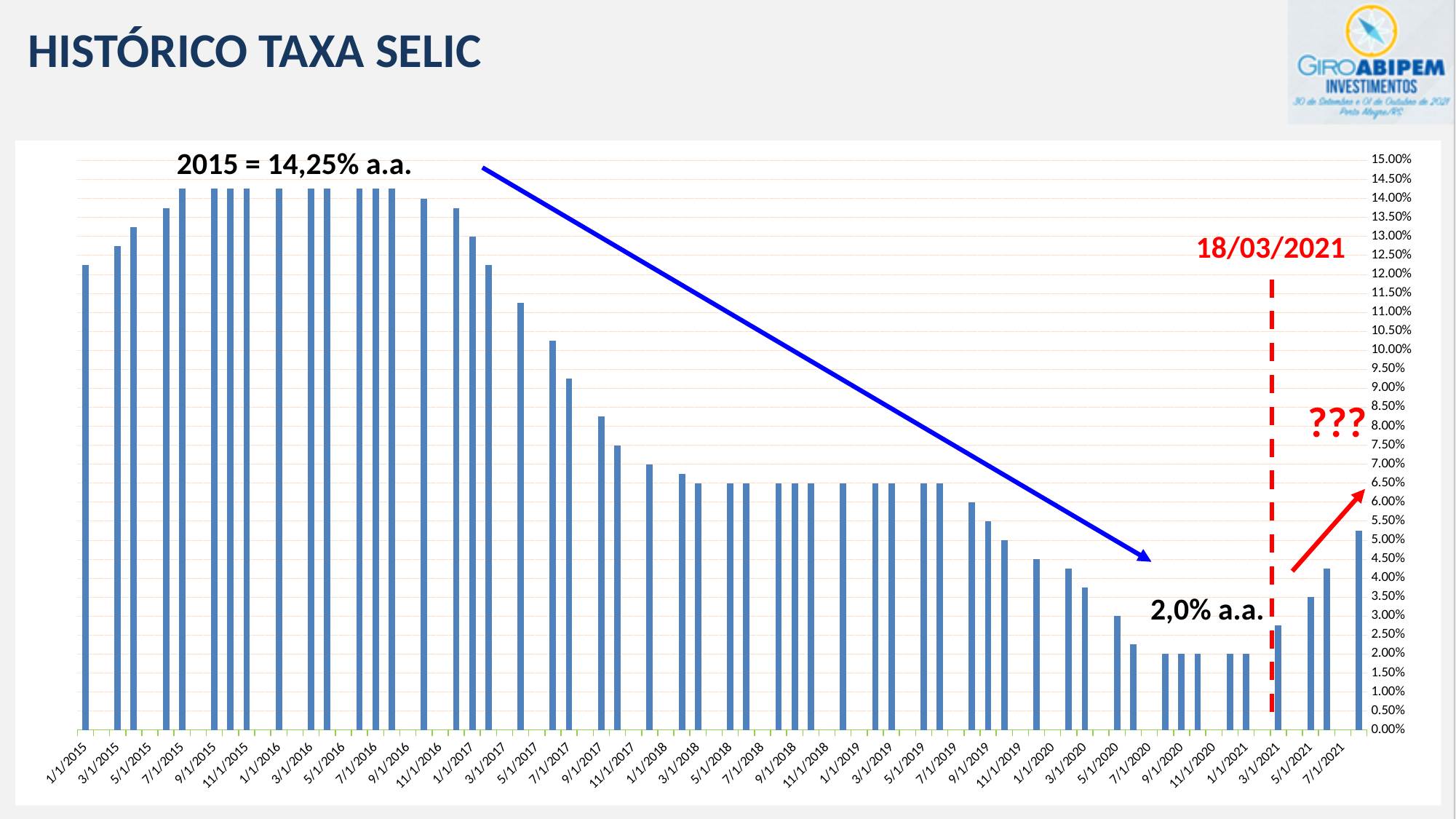
Do the values generally rise or fall from 1/1/2016 to 1/1/2020? fall Is the value for 5/1/2018 greater or less than 7.00%? less Which is larger, the value for 1/1/2015 or the value for 1/1/2021? 1/1/2015 What date is marked by the red dashed vertical line on the chart? 18/03/2021 Is the value for 7/1/2017 greater or less than 11.00%? less Is the value for 1/1/2021 greater or less than 2.50%? less According to the annotation near the lowest bars, what was the Selic rate at its low point? 2,0% a.a. What is the title of the chart on the slide? HISTÓRICO TAXA SELIC What kind of chart is shown on the slide? bar chart According to the annotation on the chart, what was the Selic rate in 2015? 14,25% a.a.